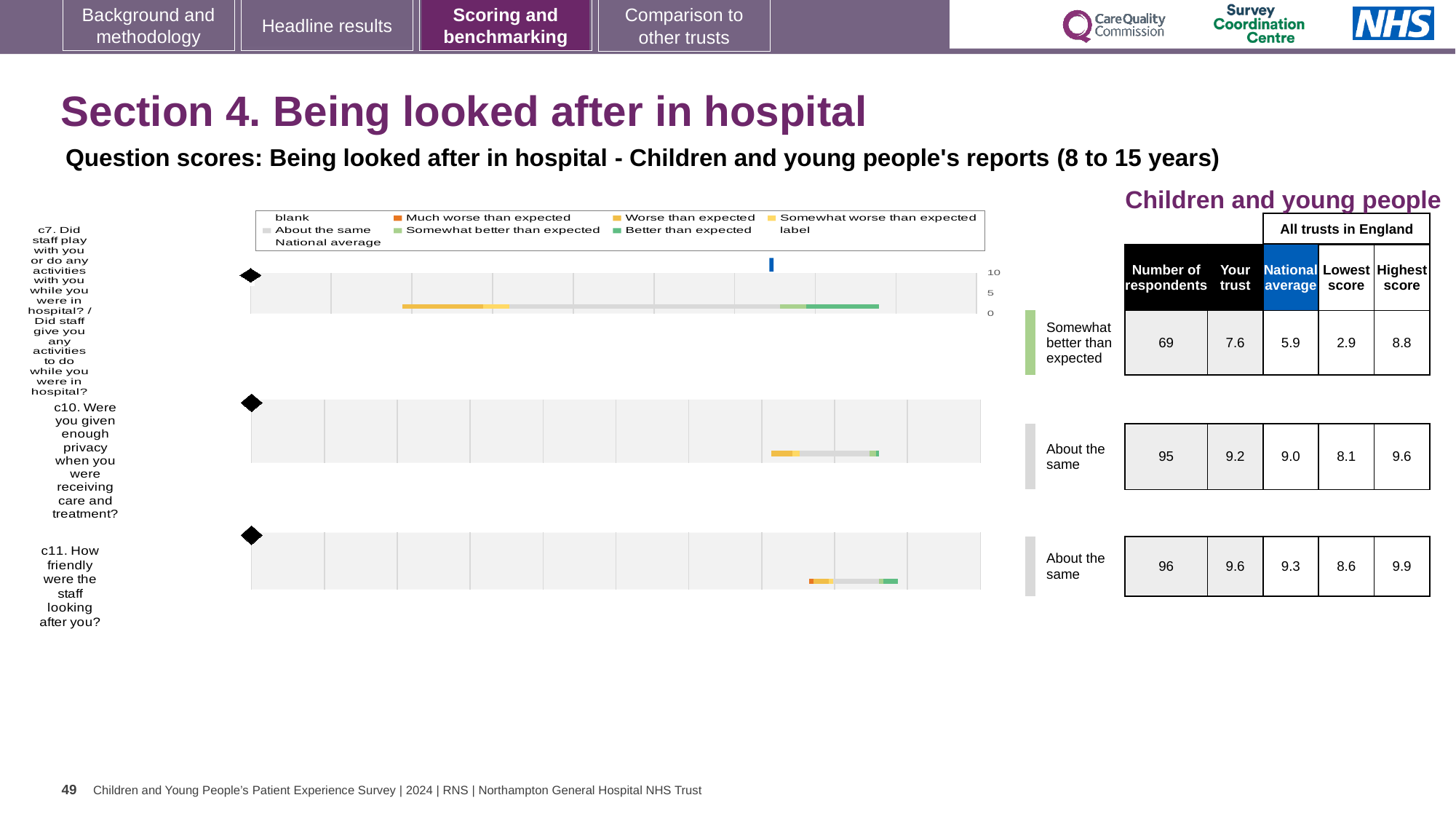
What is the lowest score across all trusts in England for question c7? 2.9 What is the maximum value shown on the score axis of the charts? 10 Which question has the highest 'Your trust' score? c11. How friendly were the staff looking after you? By how much does the trust's score for question c7 exceed the national average? 1.7 What is the 'Your trust' score for question c7 (Did staff play with you or do any activities with you while you were in hospital?)? 7.6 How many survey questions are plotted on the slide? 3 What is the national average score for question c10 (Were you given enough privacy when you were receiving care and treatment?)? 9.0 Which question has the lowest number of respondents? c7. Did staff play with you or do any activities with you while you were in hospital? What benchmark category is question c7 rated as? Somewhat better than expected For question c10, is the trust's score higher or lower than the national average? higher What kind of chart is used to show the question scores? bar chart How many respondents answered question c11 (How friendly were the staff looking after you?)? 96